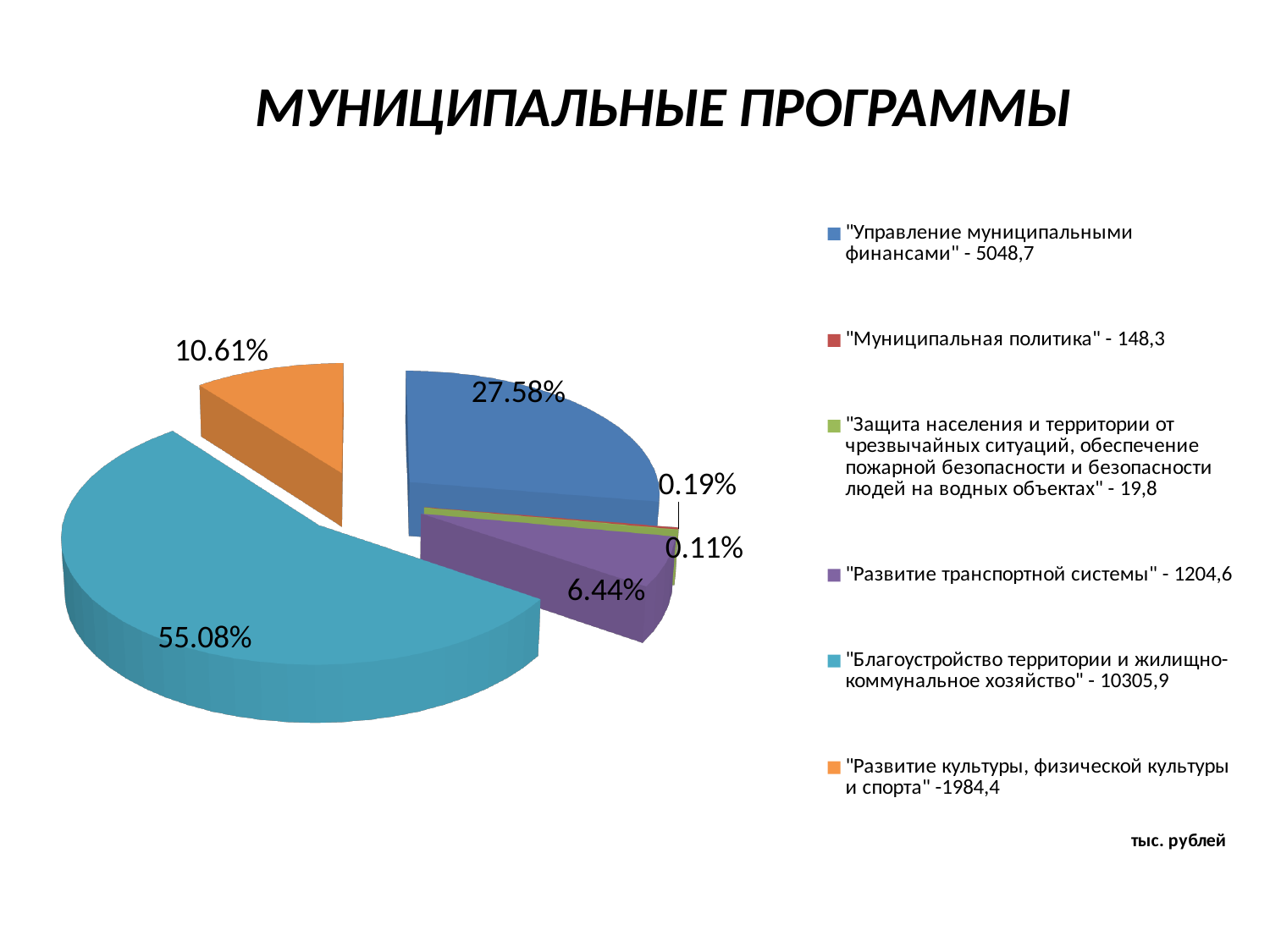
Which program has the largest slice of the pie? "Благоустройство территории и жилищно-коммунальное хозяйство" Which program has the smallest slice of the pie? "Защита населения и территории от чрезвычайных ситуаций, обеспечение пожарной безопасности и безопасности людей на водных объектах" What value in thousands of rubles does the legend give for "Муниципальная политика"? 148,3 Which is larger: the share for "Развитие культуры, физической культуры и спорта" or the share for "Развитие транспортной системы"? "Развитие культуры, физической культуры и спорта" What is the title of the chart on the slide? МУНИЦИПАЛЬНЫЕ ПРОГРАММЫ What share of the pie does "Управление муниципальными финансами" take? 27.58% What share of the pie does "Благоустройство территории и жилищно-коммунальное хозяйство" take? 55.08% What type of chart is shown on the slide? pie chart What share of the pie does "Развитие транспортной системы" take? 6.44% How many slices does the pie chart have? 6 What value in thousands of rubles does the legend give for "Развитие транспортной системы"? 1204,6